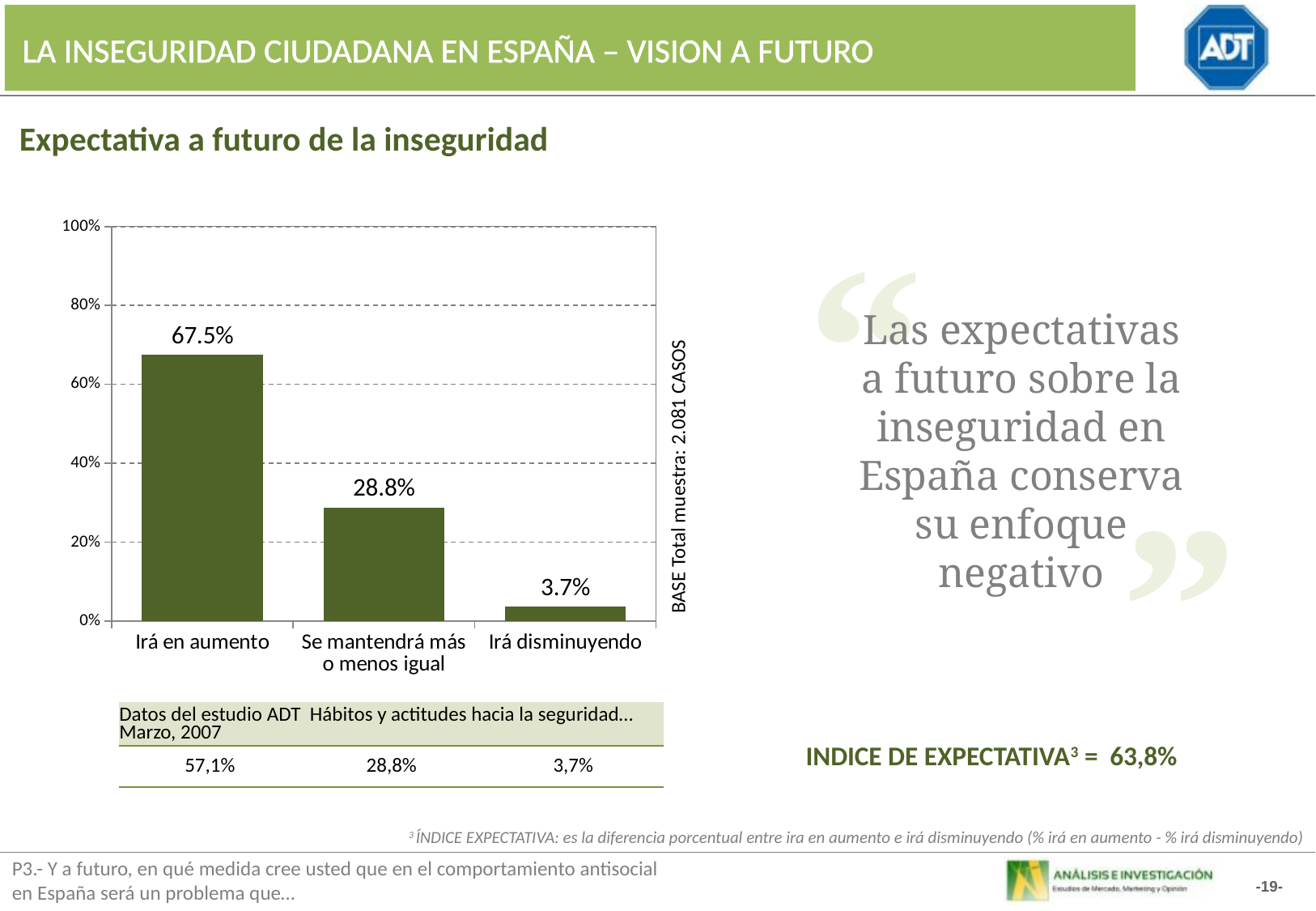
What is the difference between the values for "Se mantendrá más o menos igual" and "Irá disminuyendo"? 25.1% How many categories are shown in the chart? 3 Which category has the lowest value? Irá disminuyendo Which category has the highest value? Irá en aumento Is the value for "Irá en aumento" greater or less than 60%? greater What is the value for "Irá disminuyendo"? 3.7% What is the value for "Irá en aumento"? 67.5% Do the values rise or fall from left to right across the categories? fall Which is larger, the value for "Irá en aumento" or the value for "Se mantendrá más o menos igual"? Irá en aumento What is the difference between the values for "Irá en aumento" and "Se mantendrá más o menos igual"? 38.7% What is the value for "Se mantendrá más o menos igual"? 28.8% What kind of chart is shown on the slide? bar chart